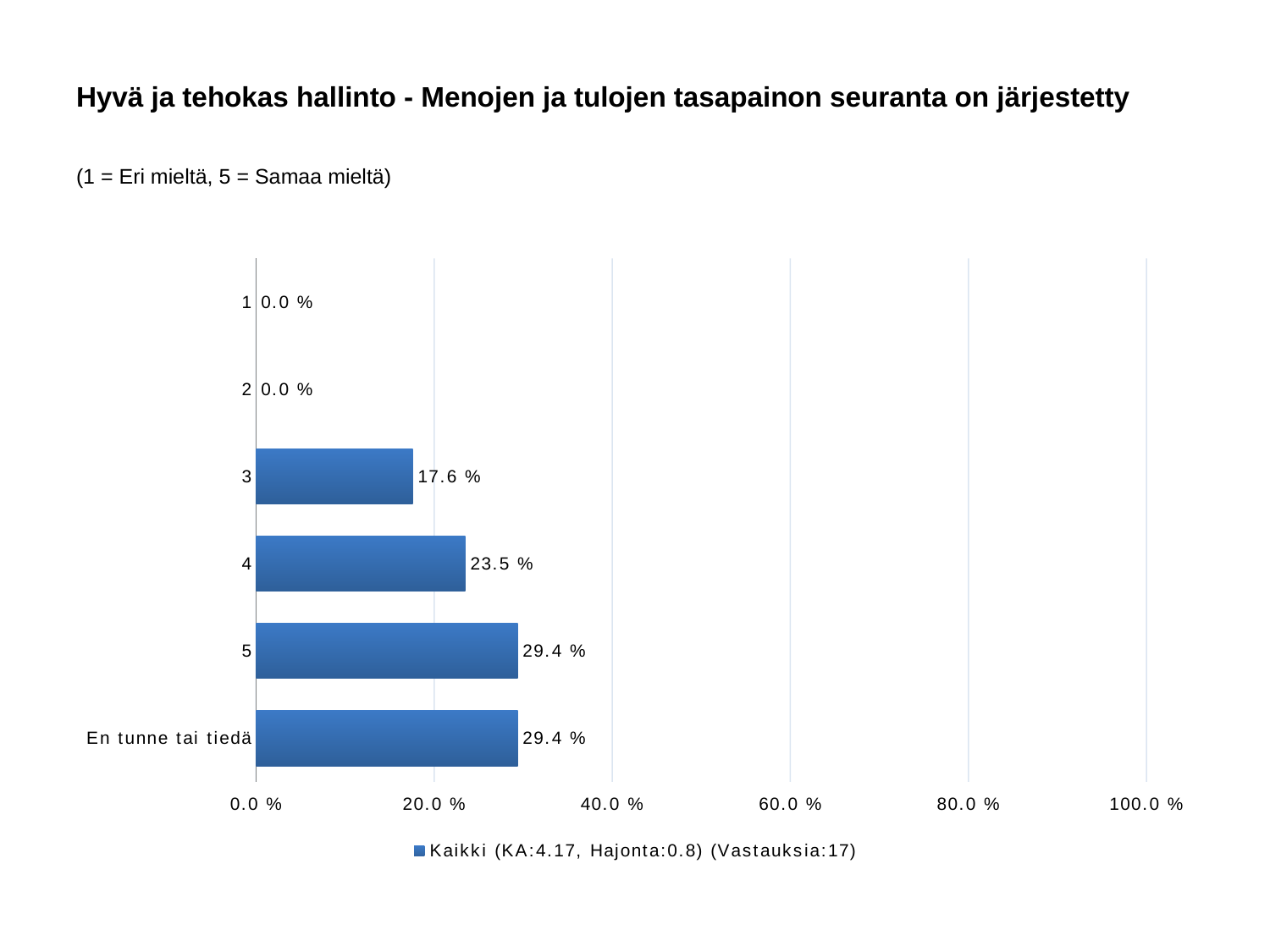
What is the value for category 1? 0.0 % What is the difference between the values for category 5 and category 3? 11.8 % What is the value for category 3? 17.6 % Is the value for category 4 greater or less than 20.0 %? greater What kind of chart is shown on the slide? bar chart What is the value for category 5? 29.4 % What is the value for category 4? 23.5 % What is the legend entry of the chart? Kaikki (KA:4.17, Hajonta:0.8) (Vastauksia:17) What is the value for 'En tunne tai tiedä'? 29.4 % How many categories are shown on the chart? 6 Which category has the lowest value among 3, 4 and 5? 3 Which is larger, the value for category 4 or the value for category 3? 4